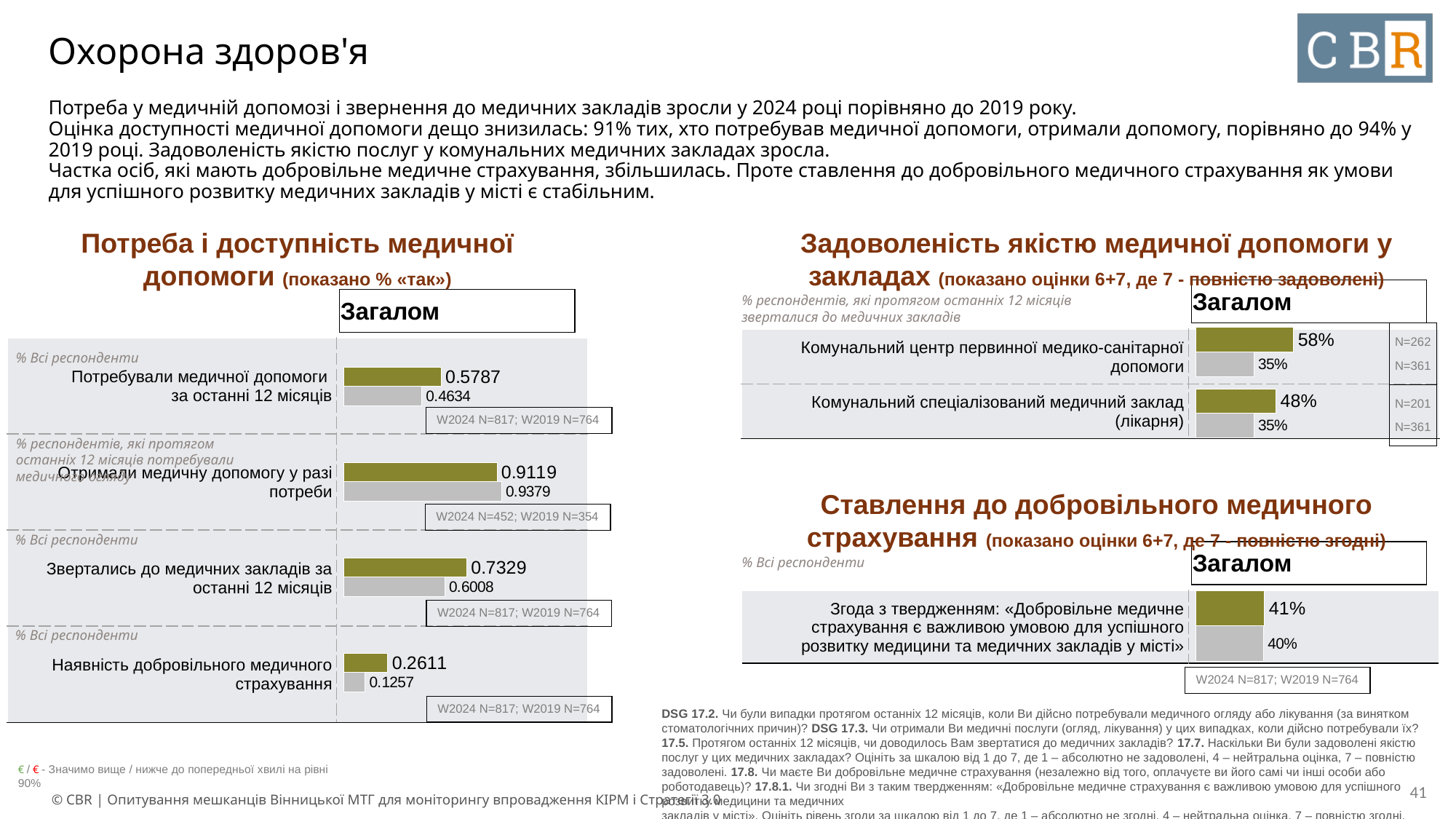
In the chart 'Ставлення до добровільного медичного страхування', what is the difference between the olive bar (41%) and the grey bar (40%)? 1% What type of chart is 'Ставлення до добровільного медичного страхування'? Bar chart In the chart 'Потреба і доступність медичної допомоги', what value is shown on the lower (grey) bar for 'Отримали медичну допомогу у разі потреби'? 0.9379 In the chart 'Потреба і доступність медичної допомоги', what is the difference between the olive bar (0.7329) and the grey bar (0.6008) for 'Звертались до медичних закладів за останні 12 місяців'? 0.1321 In the chart 'Задоволеність якістю медичної допомоги у закладах', what is the grey-bar value for 'Комунальний спеціалізований медичний заклад (лікарня)'? 35% In the chart 'Задоволеність якістю медичної допомоги у закладах', what is the olive-bar value for 'Комунальний центр первинної медико-санітарної допомоги'? 58% In the chart 'Потреба і доступність медичної допомоги', what value is shown on the upper (olive) bar for 'Потребували медичної допомоги за останні 12 місяців'? 0.5787 In the chart 'Задоволеність якістю медичної допомоги у закладах', which is larger: the olive bar for 'Комунальний центр первинної медико-санітарної допомоги' or the olive bar for 'Комунальний спеціалізований медичний заклад (лікарня)'? Комунальний центр первинної медико-санітарної допомоги In the chart 'Потреба і доступність медичної допомоги', which category has the highest olive-bar value? Отримали медичну допомогу у разі потреби In the chart 'Потреба і доступність медичної допомоги', what value is shown on the grey bar for 'Наявність добровільного медичного страхування'? 0.1257 In the chart 'Потреба і доступність медичної допомоги', how many categories are shown? 4 In the chart 'Потреба і доступність медичної допомоги', which category has the lowest olive-bar value? Наявність добровільного медичного страхування